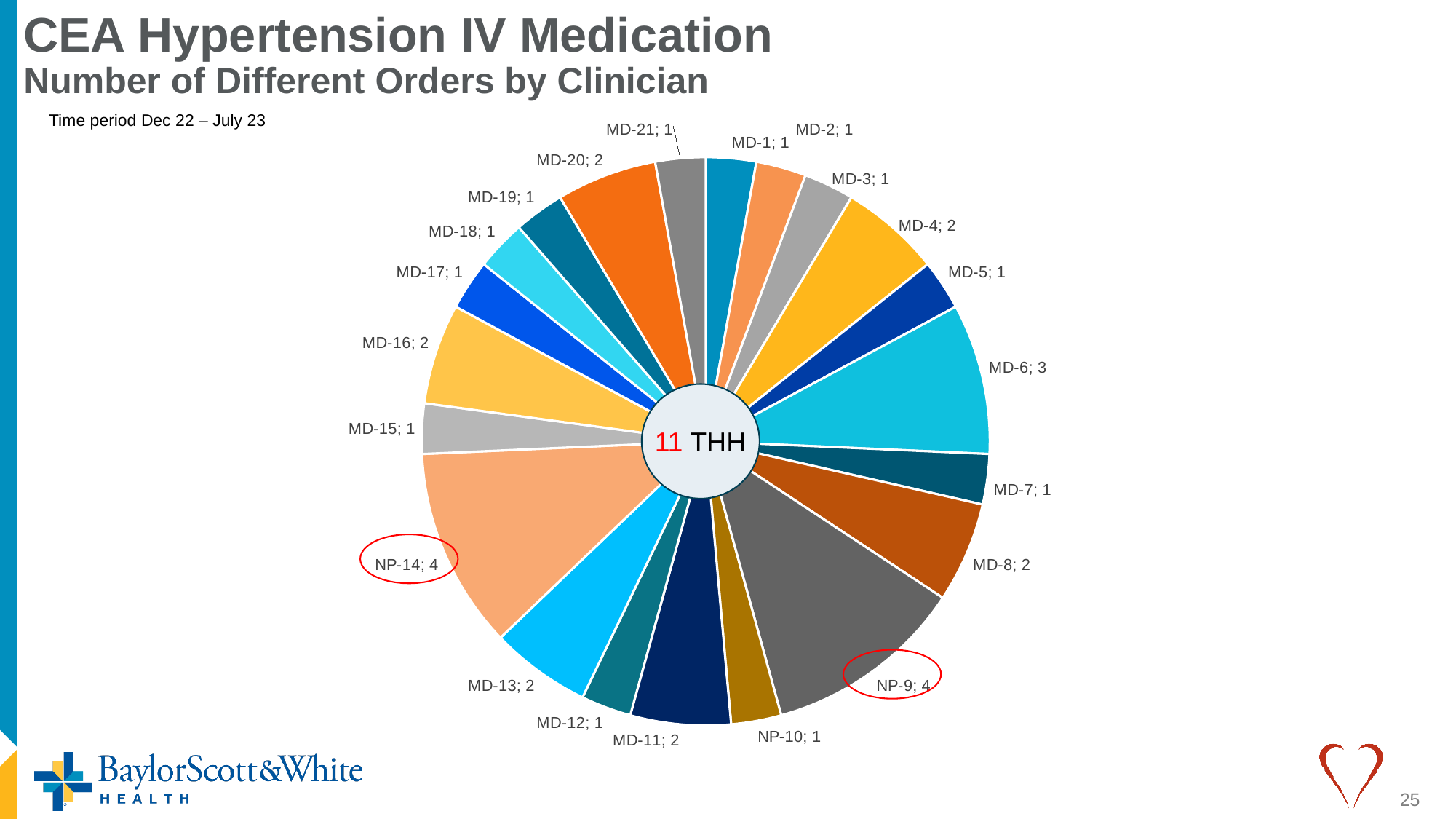
What is the difference between the values for NP-9 and MD-6? 1 What kind of chart is shown on the slide? Pie chart Which two clinicians share the highest value in the chart? NP-9 and NP-14 What is the value shown for NP-14? 4 Which has the larger value, MD-4 or MD-5? MD-4 Which two labels are circled in red on the chart? NP-14; 4 and NP-9; 4 What text appears in the centre of the chart? 11 THH What is the difference between the values for NP-14 and MD-12? 3 What is the value shown for MD-20? 2 What is the value shown for MD-6? 3 How many clinician slices are shown in the chart? 21 What is the value shown for NP-10? 1